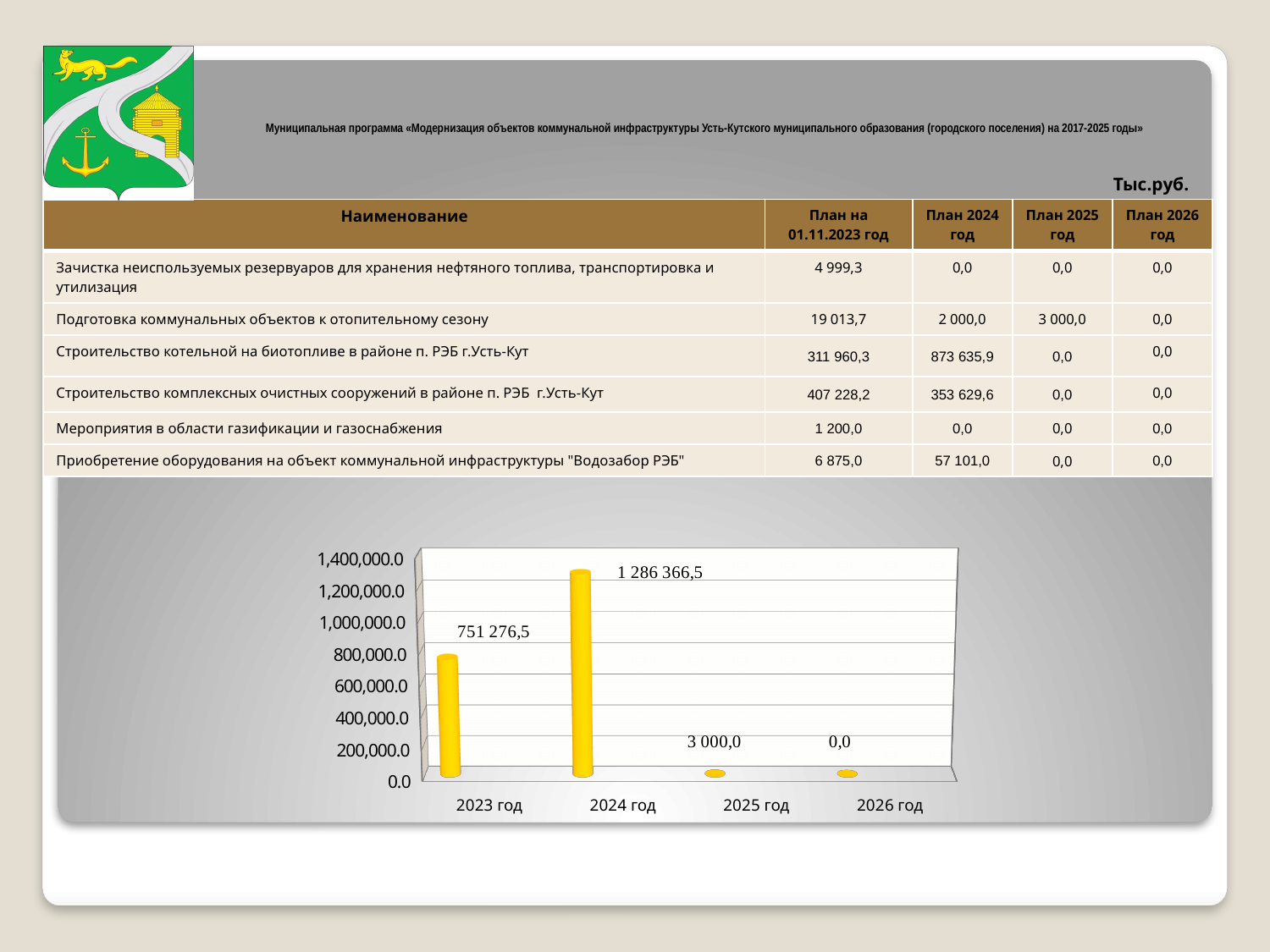
What is the value for 2026 год in the chart? 0,0 Which is larger in the chart, the value for 2023 год or the value for 2025 год? 2023 год Does the value rise or fall from 2024 год to 2025 год in the chart? fall What is the value for 2024 год in the chart? 1 286 366,5 What is the difference between the values for 2024 год and 2023 год in the chart? 535 090,0 Which year has the highest value in the chart? 2024 год What is the value for 2023 год in the chart? 751 276,5 What kind of chart is shown on the slide? bar chart Which year has the lowest value in the chart? 2026 год Is the value for 2023 год in the chart greater or less than 600,000.0? greater How many years are shown on the x axis of the chart? 4 What is the value for 2025 год in the chart? 3 000,0